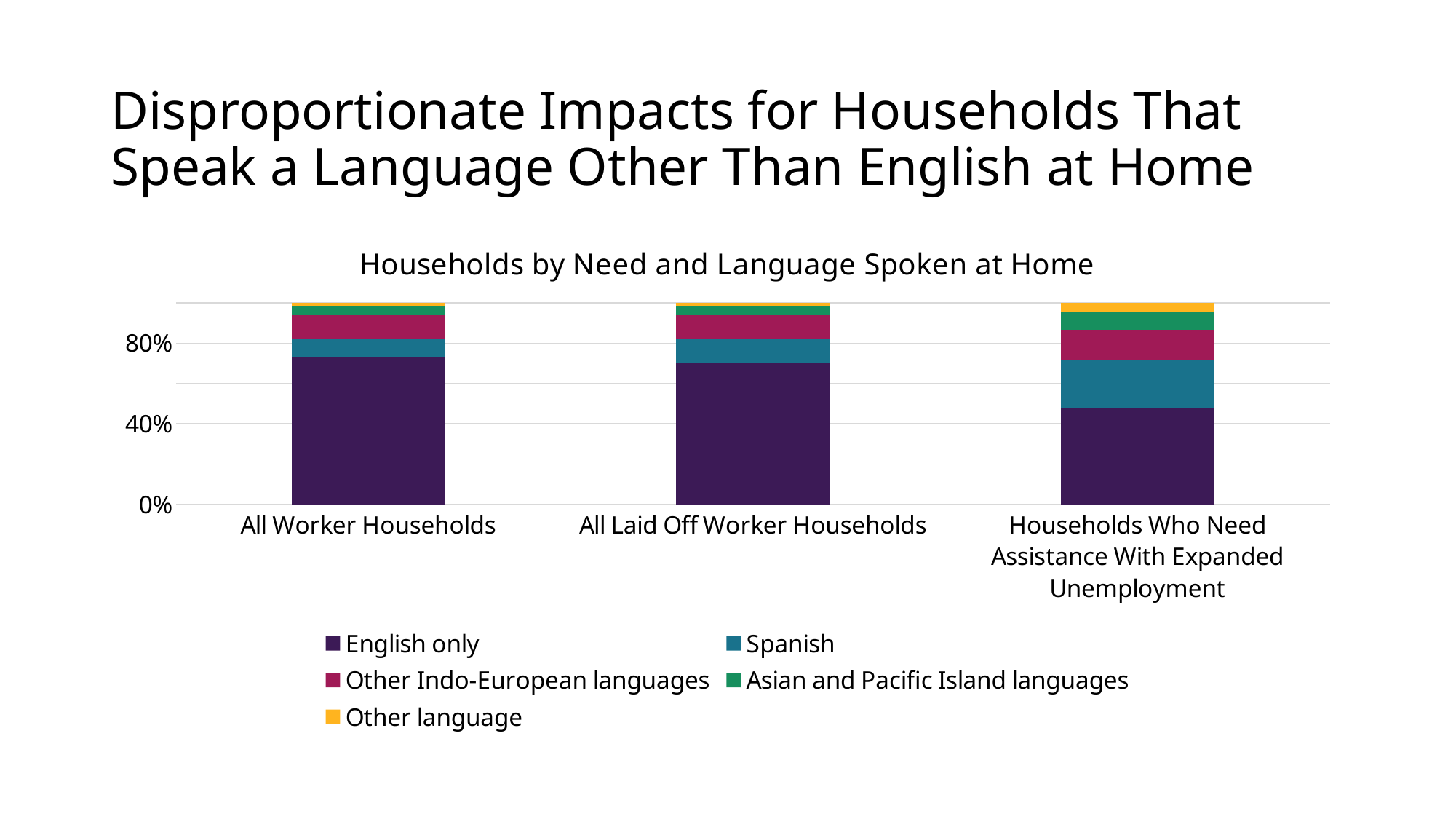
Does the English only share rise or fall moving from left to right across the three categories? Falls What kind of chart is shown on the slide? Stacked bar chart Is the English only share for Households Who Need Assistance With Expanded Unemployment greater or less than 40%? greater Which household category has the smallest English only share? Households Who Need Assistance With Expanded Unemployment Is the English only share for All Laid Off Worker Households greater or less than 40%? greater Is the English only share larger for All Worker Households or for Households Who Need Assistance With Expanded Unemployment? All Worker Households Is the English only share for All Worker Households greater or less than 80%? less Which language series is shown in yellow in the legend? Other language How many household categories are shown along the x axis? 3 How many language series does the legend list? 5 What is the title of the chart? Households by Need and Language Spoken at Home Which household category has the largest Spanish share? Households Who Need Assistance With Expanded Unemployment